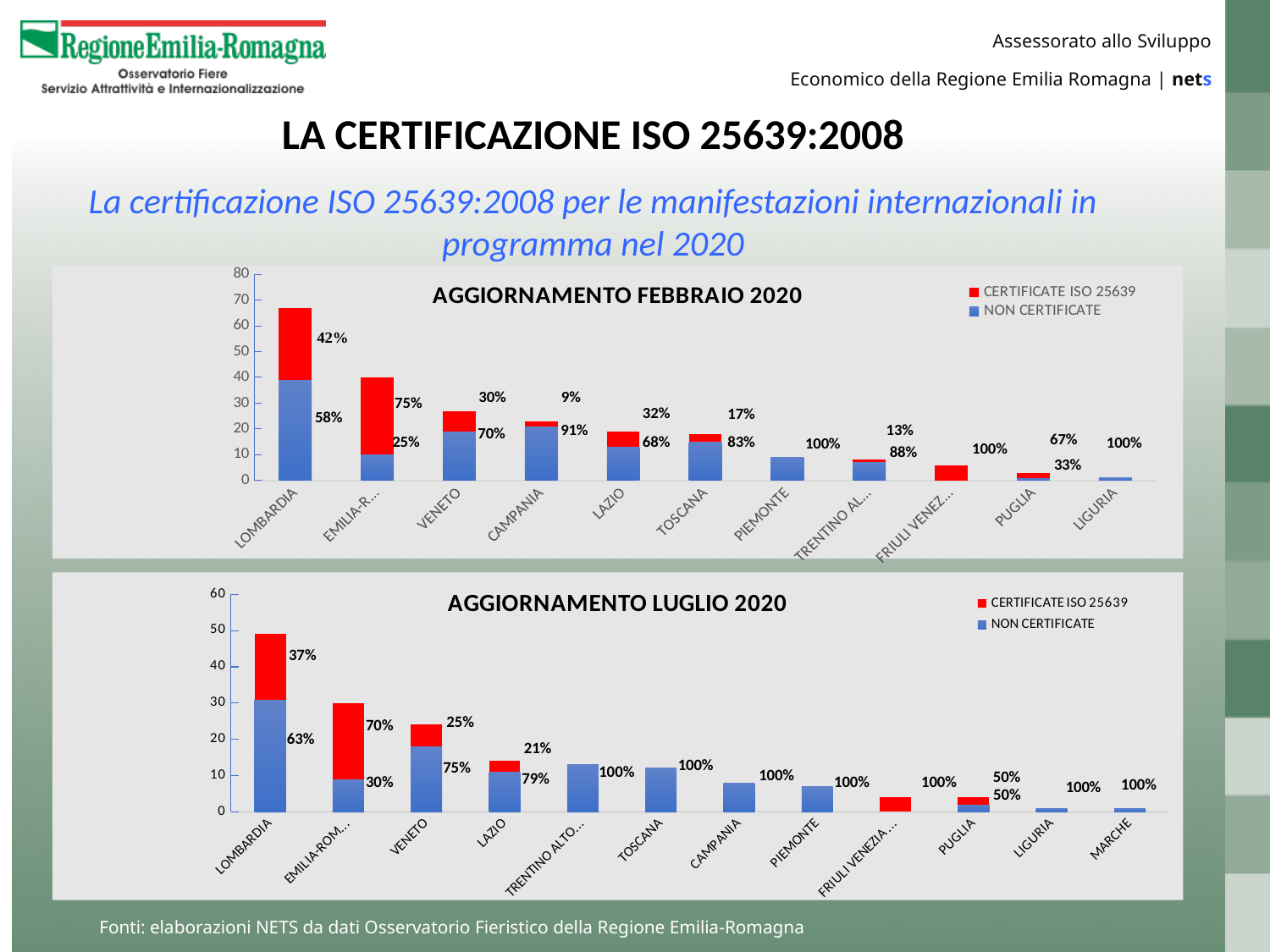
How many regions are shown on the x axis of the AGGIORNAMENTO LUGLIO 2020 chart? 12 How many series does the legend of the AGGIORNAMENTO FEBBRAIO 2020 chart list? 2 What type of chart is the AGGIORNAMENTO LUGLIO 2020 chart? Stacked bar chart In the AGGIORNAMENTO LUGLIO 2020 chart, what percentage label is shown for the NON CERTIFICATE segment of VENETO? 75% In the AGGIORNAMENTO FEBBRAIO 2020 chart, what percentage label is shown for the NON CERTIFICATE segment of CAMPANIA? 91% In the AGGIORNAMENTO FEBBRAIO 2020 chart, which region has the tallest stacked bar? LOMBARDIA In the AGGIORNAMENTO LUGLIO 2020 chart, is the total height of the VENETO bar greater or less than 30? less In the AGGIORNAMENTO LUGLIO 2020 chart, which region has the tallest stacked bar? LOMBARDIA In the AGGIORNAMENTO FEBBRAIO 2020 chart, is the total height of the LOMBARDIA bar greater or less than 60? greater How many regions are shown on the x axis of the AGGIORNAMENTO FEBBRAIO 2020 chart? 11 In the AGGIORNAMENTO FEBBRAIO 2020 chart, what percentage label is shown for the red CERTIFICATE ISO 25639 segment of LOMBARDIA? 42% In the AGGIORNAMENTO LUGLIO 2020 chart, what percentage label is shown for the red CERTIFICATE ISO 25639 segment of LAZIO? 21%